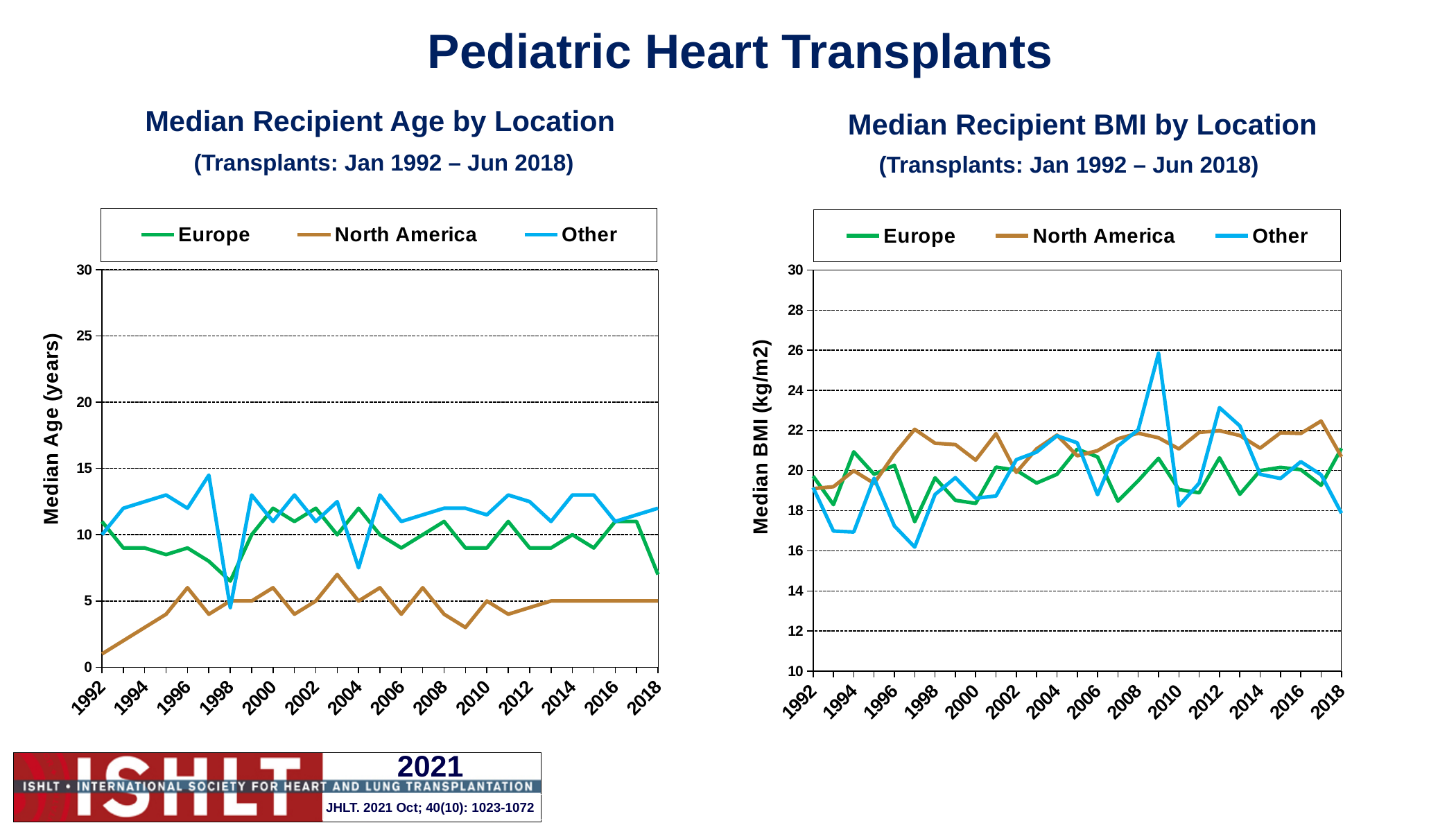
How many series does the legend of the 'Median Recipient BMI by Location' chart list? 3 In the 'Median Recipient Age by Location' chart, is the value for Europe in 2018 greater or less than 10? less What type of chart is the 'Median Recipient Age by Location' chart? line chart In the 'Median Recipient BMI by Location' chart, which series reaches the highest peak value? Other In the 'Median Recipient Age by Location' chart, what is the median age for North America in 2018? 5 In the 'Median Recipient Age by Location' chart, does the North America line rise or fall from 1992 to 1997? rise In the 'Median Recipient BMI by Location' chart, is the value for Other in 1997 greater or less than 18? less In the 'Median Recipient Age by Location' chart, which series has the lowest values across the whole period? North America In the 'Median Recipient BMI by Location' chart, is the value for Other in 2009 greater or less than 24? greater In the 'Median Recipient BMI by Location' chart, which is larger in 2009, Other or Europe? Other What is the y-axis label of the 'Median Recipient BMI by Location' chart? Median BMI (kg/m2)